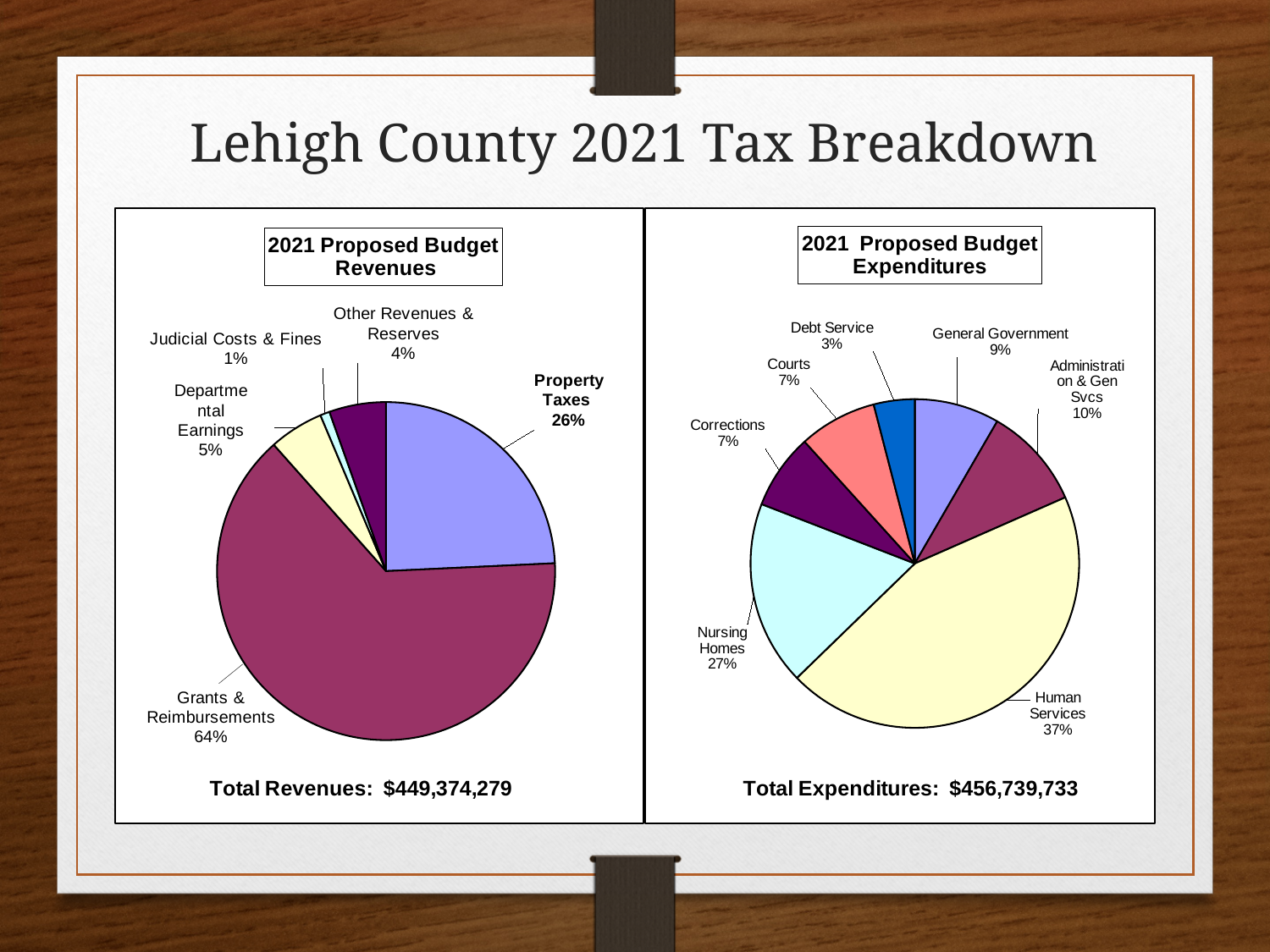
In the 2021 Proposed Budget Revenues chart, which category has the smallest share? Judicial Costs & Fines In the 2021 Proposed Budget Revenues chart, how many categories are shown? 5 In the 2021 Proposed Budget Expenditures chart, which category has the smallest share? Debt Service What total revenues figure is printed below the 2021 Proposed Budget Revenues chart? $449,374,279 In the 2021 Proposed Budget Expenditures chart, which category has the largest share? Human Services In the 2021 Proposed Budget Revenues chart, what is the difference in percentage points between Grants & Reimbursements and Property Taxes? 38 What kind of chart is the 2021 Proposed Budget Expenditures chart? Pie chart In the 2021 Proposed Budget Revenues chart, which category has the largest share? Grants & Reimbursements In the 2021 Proposed Budget Revenues chart, what share of revenues comes from Property Taxes? 26% In the 2021 Proposed Budget Expenditures chart, which is larger, Administration & Gen Svcs or General Government? Administration & Gen Svcs In the 2021 Proposed Budget Expenditures chart, what share goes to Nursing Homes? 27% In the 2021 Proposed Budget Expenditures chart, how many categories are shown? 7